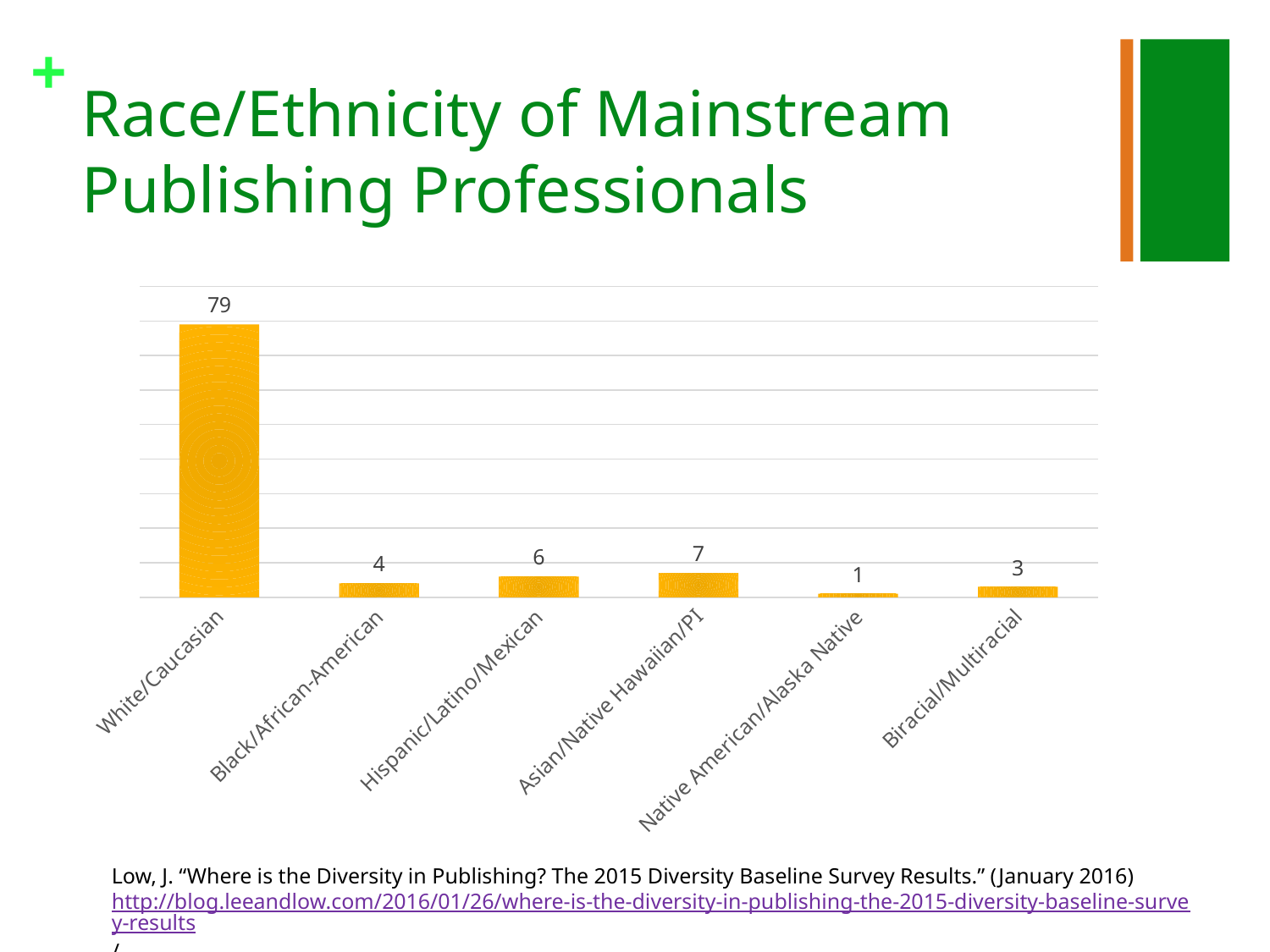
What is the value for Native American/Alaska Native? 1 Which category has the highest value? White/Caucasian Which is larger, the value for Hispanic/Latino/Mexican or the value for Black/African-American? Hispanic/Latino/Mexican What is the value for Biracial/Multiracial? 3 What is the value for Hispanic/Latino/Mexican? 6 How many categories are shown in the chart? 6 What is the difference between the values for White/Caucasian and Asian/Native Hawaiian/PI? 72 What is the value for Asian/Native Hawaiian/PI? 7 What kind of chart is shown on the slide? Bar chart What is the value for White/Caucasian? 79 What is the value for Black/African-American? 4 Which category has the lowest value? Native American/Alaska Native